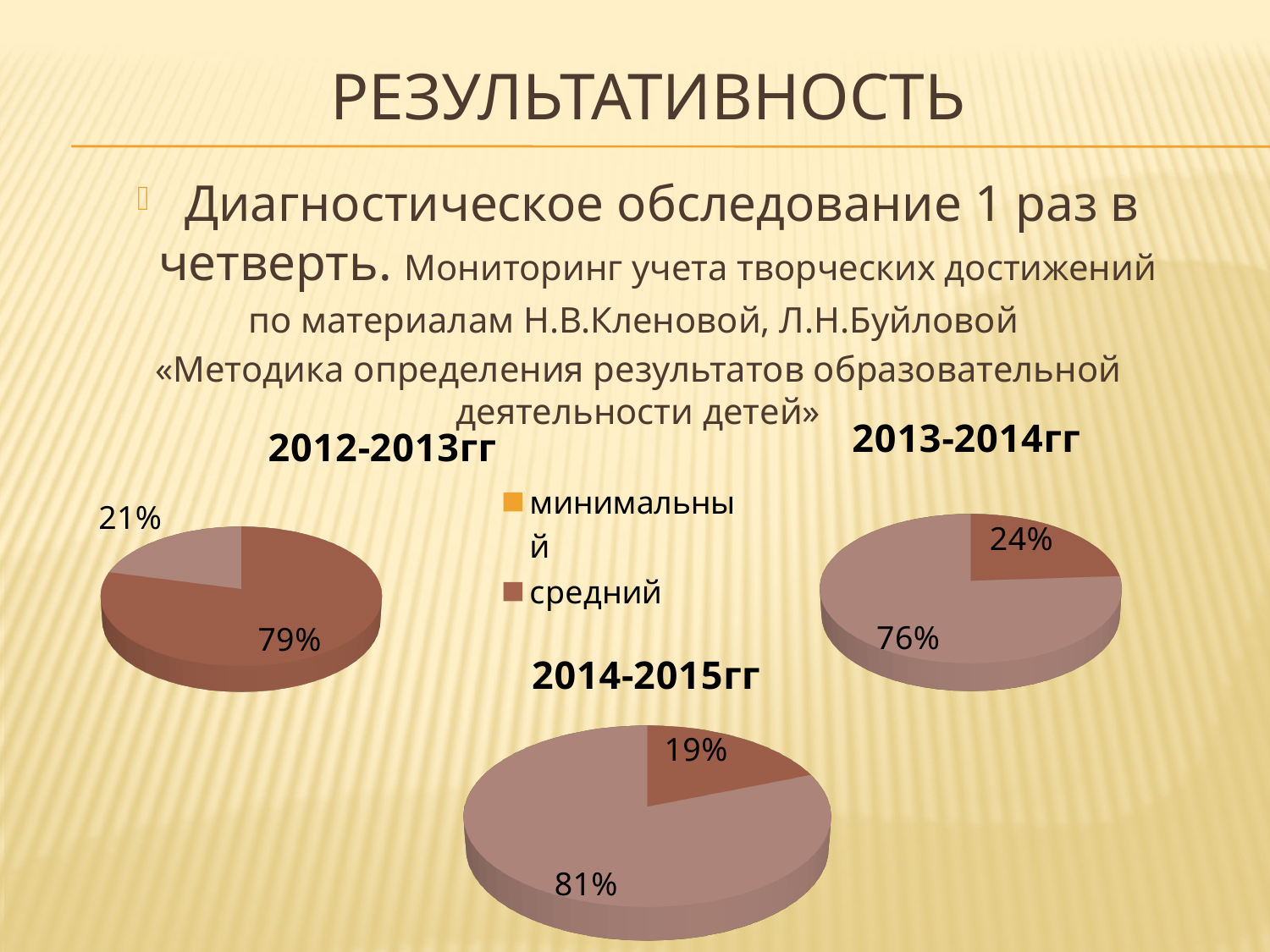
How many slices does the 2013-2014гг pie chart have? 2 On the 2013-2014гг pie chart, what value is shown on the larger slice? 76% How many pie charts are shown on the slide? 3 On the 2013-2014гг pie chart, what value is shown on the smaller slice? 24% On the 2012-2013гг pie chart, what is the difference between the larger and smaller slice values? 58% On the 2012-2013гг pie chart, what value is shown on the larger slice? 79% Which of the three pie charts has the largest single slice value? 2014-2015гг On the 2012-2013гг pie chart, what value is shown on the smaller slice? 21% On the 2014-2015гг pie chart, what value is shown on the larger slice? 81% How many entries does the legend list? 2 On the 2014-2015гг pie chart, what value is shown on the smaller slice? 19% What kind of chart is the 2014-2015гг chart? Pie chart